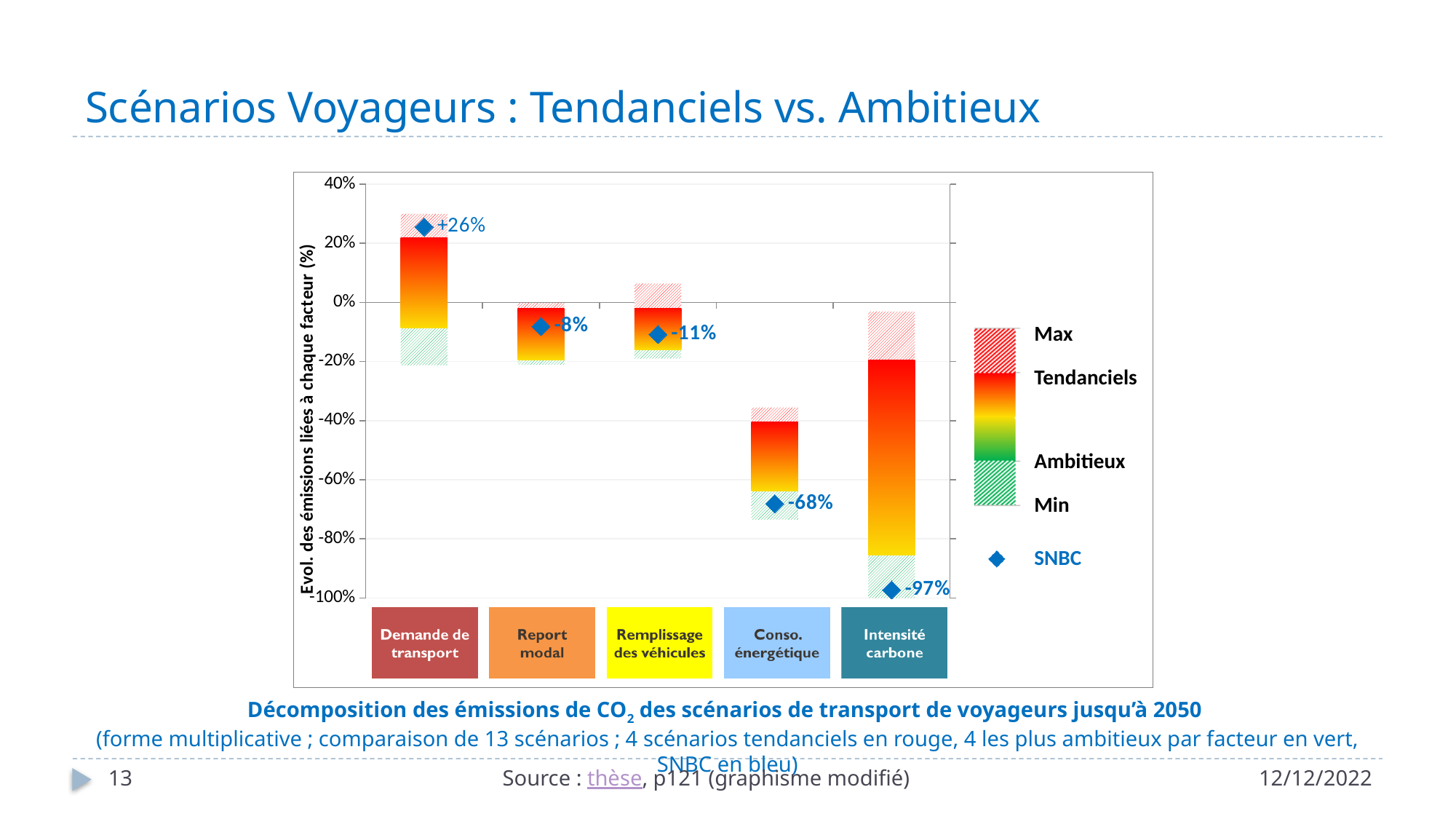
What is the SNBC value shown for Conso. énergétique? -68% What is the SNBC value shown for Demande de transport? +26% What is the SNBC value shown for Report modal? -8% Is the Max value for Remplissage des véhicules greater or less than 0%? greater What is the difference between the SNBC values for Report modal and Remplissage des véhicules? 3 percentage points What is the SNBC value shown for Intensité carbone? -97% Do the SNBC values rise or fall from left to right across the factors? fall How many factors are shown along the x axis? 5 How many entries does the legend list? 5 Which has the larger SNBC value, Conso. énergétique or Intensité carbone? Conso. énergétique Which factor has the lowest SNBC value? Intensité carbone Which factor has the highest SNBC value? Demande de transport